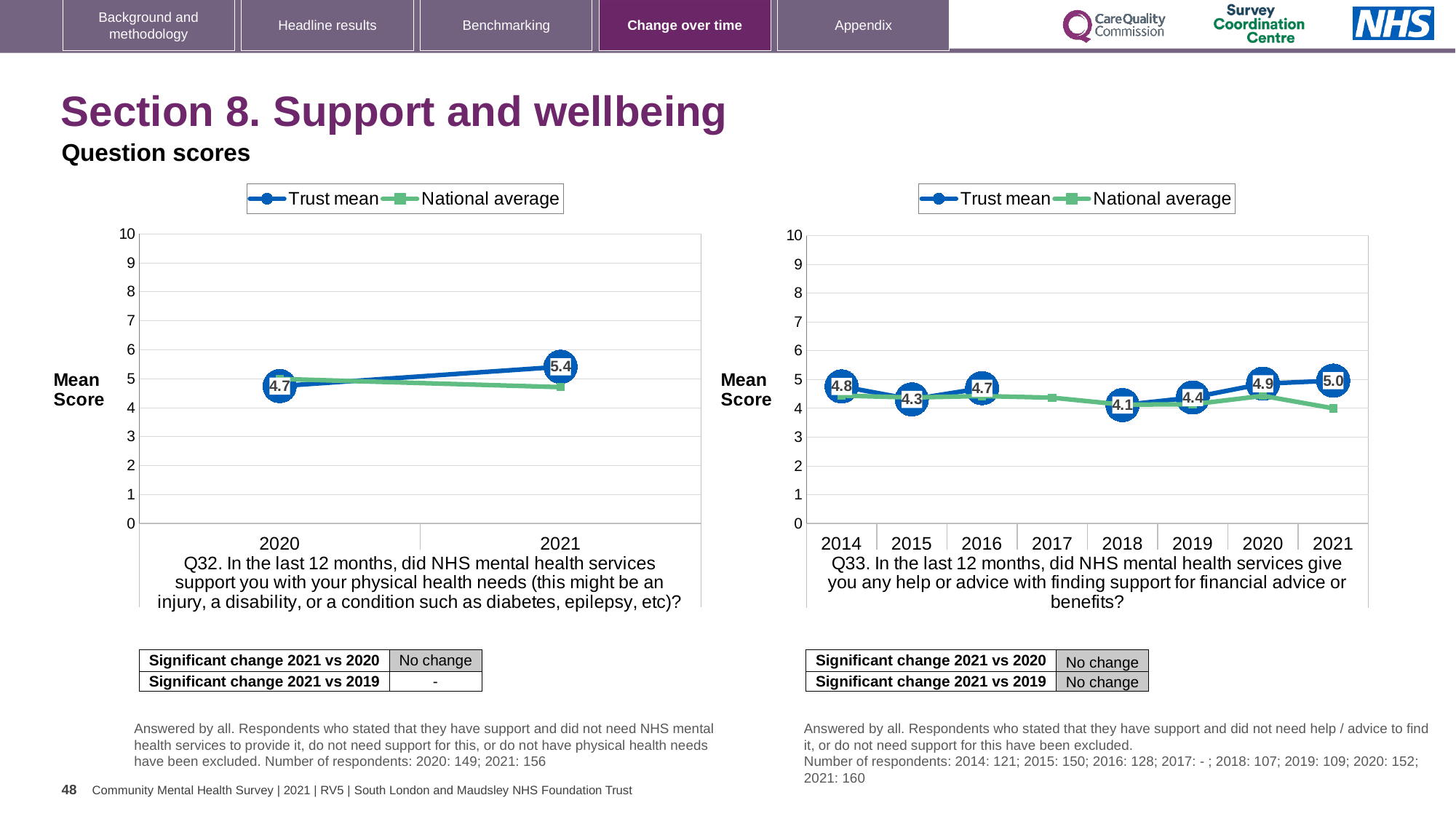
In the Q32 chart on the left, does the Trust mean rise or fall from 2020 to 2021? rise In the Q32 chart on the left, by how much did the Trust mean change from 2020 to 2021? 0.7 In the Q32 chart on the left, what is the Trust mean for 2021? 5.4 In the Q33 chart on the right, is the National average for 2021 greater or less than 5? less In the Q33 chart on the right, what is the Trust mean for 2021? 5.0 In the Q33 chart on the right, which year has the lowest Trust mean? 2018 In the Q33 chart on the right, is the Trust mean higher in 2014 or in 2015? 2014 How many series does the legend of the Q33 chart on the right list? 2 In the Q33 chart on the right, what is the Trust mean for 2018? 4.1 In the Q33 chart on the right, which year has the highest Trust mean? 2021 In the Q32 chart on the left, what is the Trust mean for 2020? 4.7 In the Q33 chart on the right, what is the difference between the Trust mean in 2021 and in 2018? 0.9